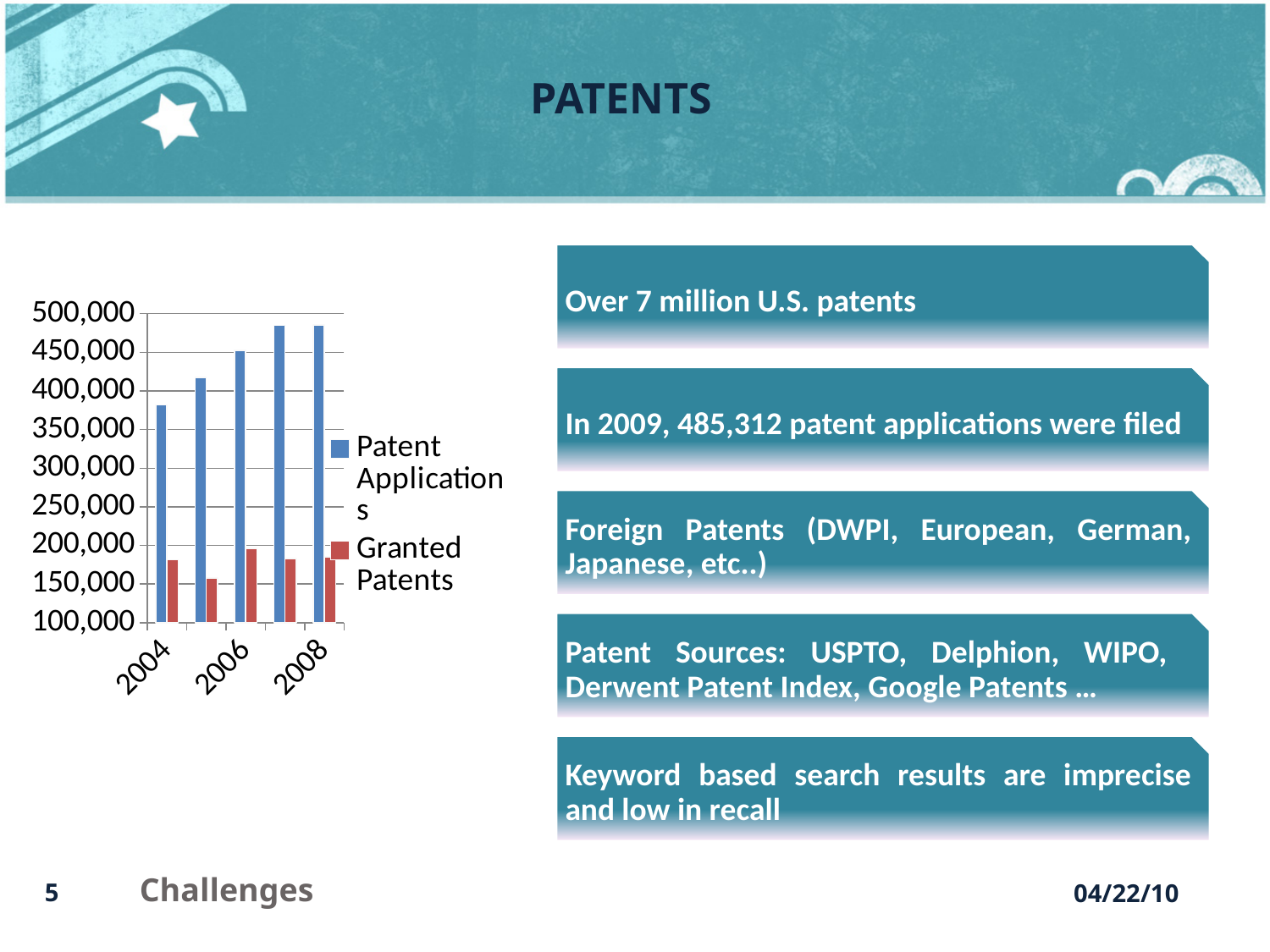
Is the value for Patent Applications in 2008 greater or less than 450,000? greater Is the value for Patent Applications in 2006 greater or less than 400,000? greater How many series does the chart's legend list? 2 Is the value for Patent Applications in 2004 greater or less than 350,000? greater What kind of chart is shown on the slide? bar chart Which colour represents Granted Patents in the chart? red Do the Patent Applications values generally rise or fall from 2004 to 2008? rise What are the two series named in the chart's legend? Patent Applications and Granted Patents How many groups of bars (years) are plotted in the chart? 5 In 2004, which is larger: Patent Applications or Granted Patents? Patent Applications